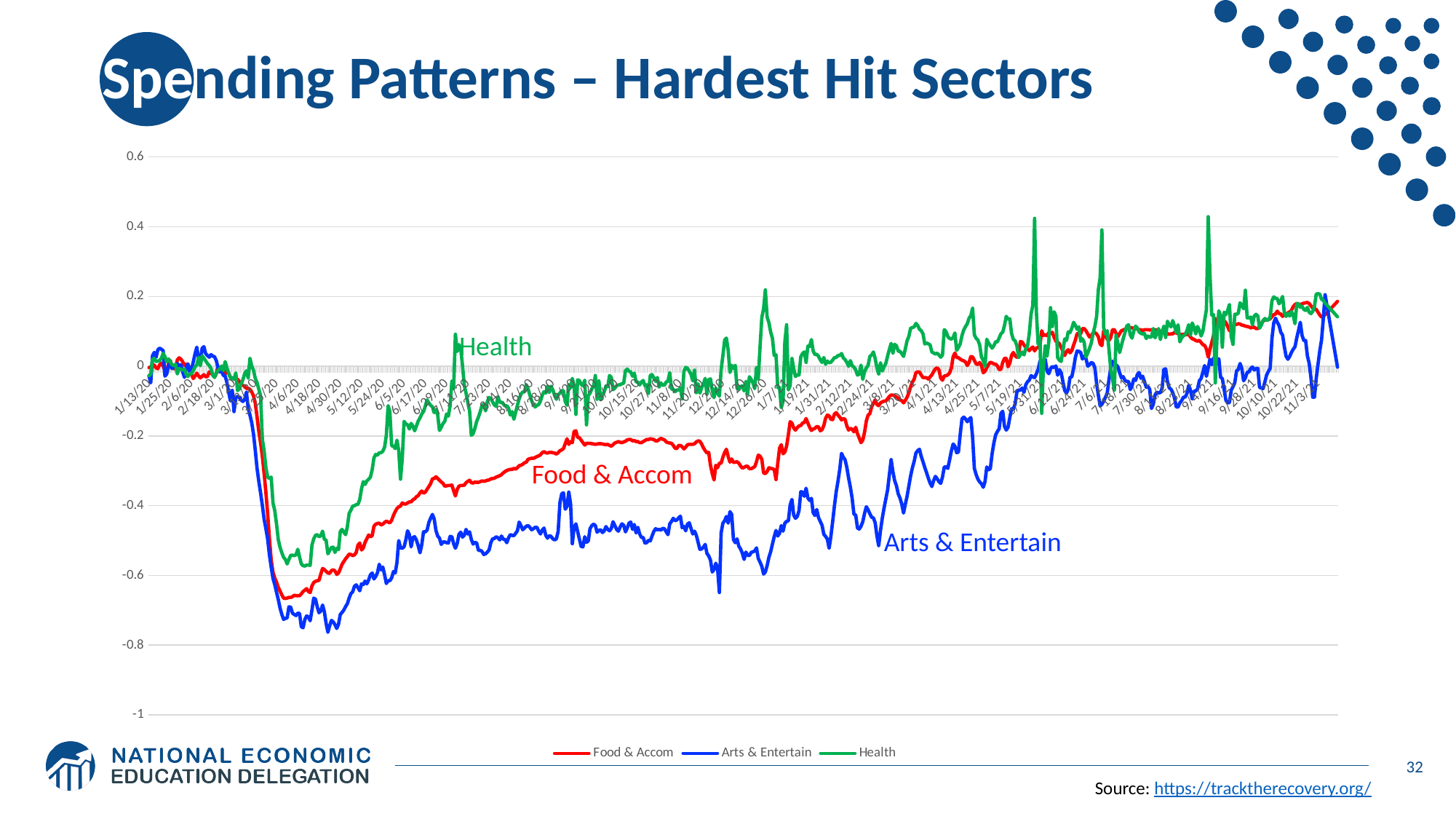
Is the value for Food & Accom around 4/6/20 greater or less than -0.4? less What is the title of the slide containing the chart? Spending Patterns – Hardest Hit Sectors Around 8/6/20, which series has the higher value, Health or Food & Accom? Health What kind of chart is shown on the slide? Line chart Is the value for Health around 4/6/20 greater or less than -0.4? less Is the value for Arts & Entertain around 4/6/20 greater or less than -0.6? less Around 4/6/20, which series has the lower value, Food & Accom or Arts & Entertain? Arts & Entertain Which series is drawn in green? Health Does the Arts & Entertain series generally rise or fall from 4/6/20 to 11/3/21? Rise How many series does the legend list? 3 Which series reaches the lowest value on the chart? Arts & Entertain